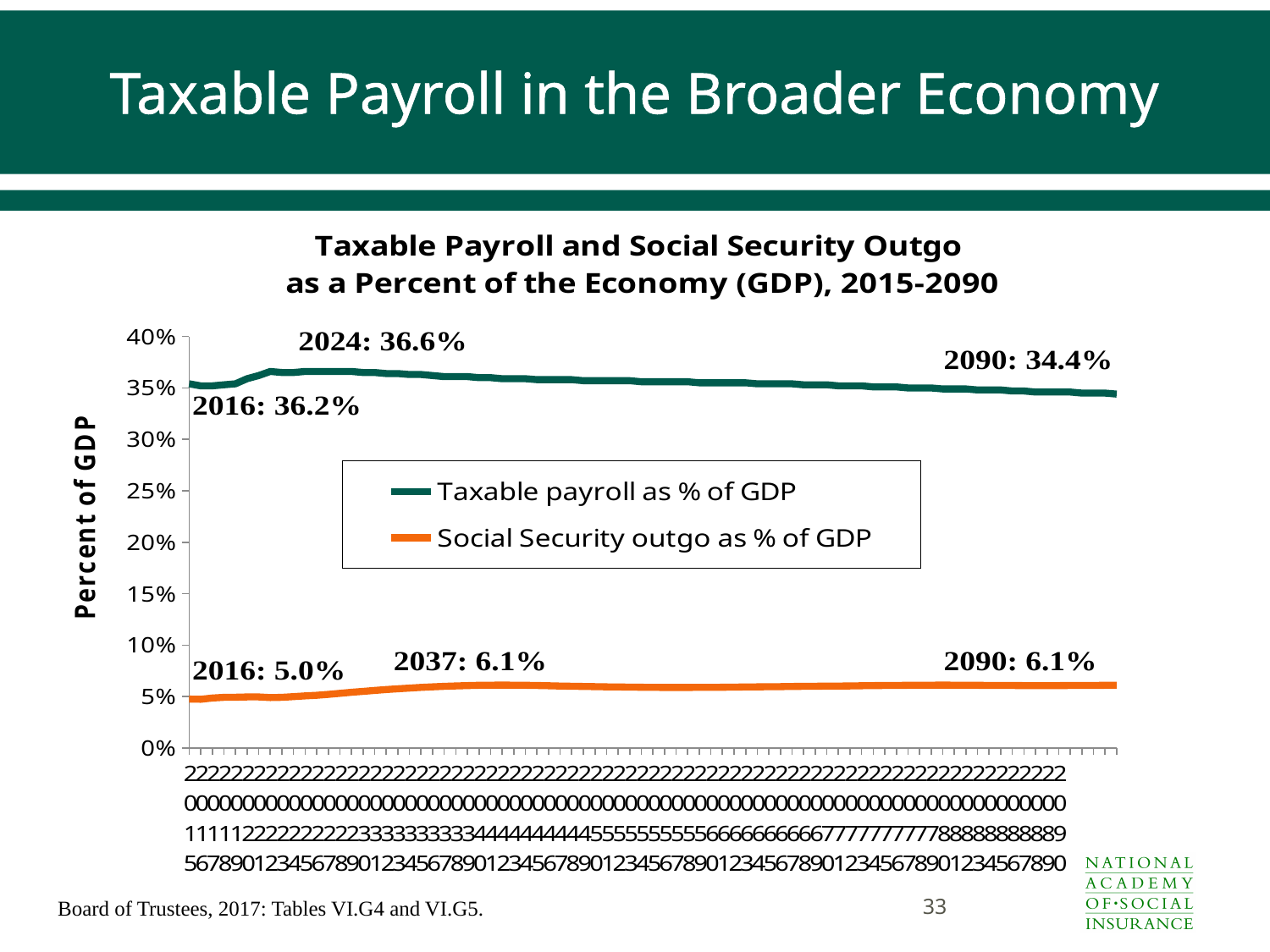
What is taxable payroll as a percent of GDP in 2090? 34.4% What is the title of the chart? Taxable Payroll and Social Security Outgo as a Percent of the Economy (GDP), 2015-2090 What is Social Security outgo as a percent of GDP in 2016? 5.0% Does taxable payroll as a percent of GDP rise or fall from 2024 to 2090? fall Is Social Security outgo as a percent of GDP in 2090 greater or less than 10%? less What is taxable payroll as a percent of GDP in 2024? 36.6% By how many percentage points does Social Security outgo as a percent of GDP rise from 2016 to 2037? 1.1 percentage points What is Social Security outgo as a percent of GDP in 2037? 6.1% How many series does the legend list? 2 What kind of chart is shown on the slide? line chart Which is larger in 2016: taxable payroll as a percent of GDP or Social Security outgo as a percent of GDP? Taxable payroll as % of GDP By how many percentage points does taxable payroll as a percent of GDP fall from 2024 to 2090? 2.2 percentage points